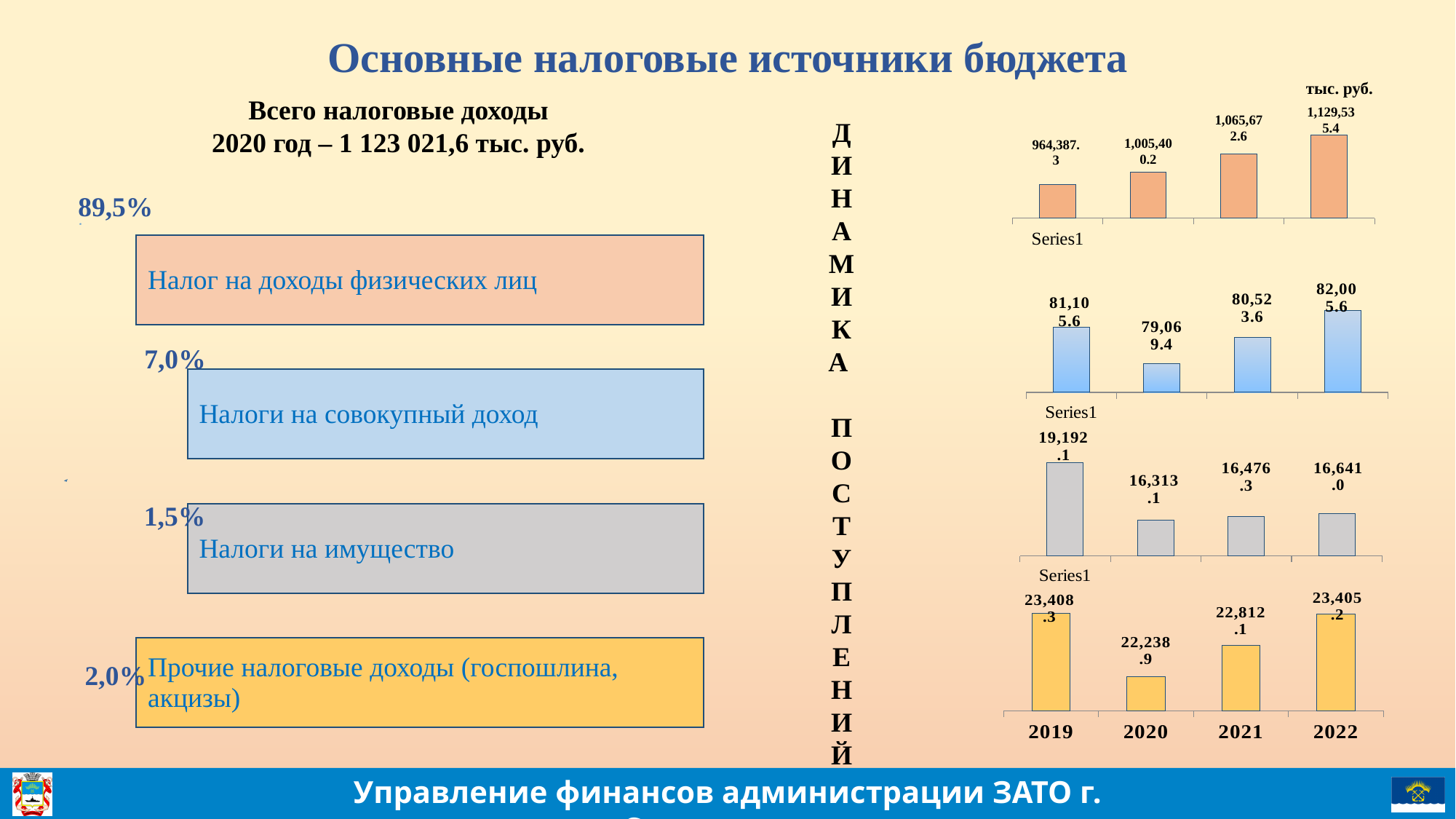
In the bottom (yellow) chart, which year has the lowest value? 2020 In the bottom (yellow) chart, what is the value for 2020? 22,238.9 In the top (orange) chart, what is the value of the rightmost bar? 1,129,535.4 In the second (blue) chart, what is the value of the lowest bar? 79,069.4 What type of chart is the bottom (yellow) chart? bar chart In the third (grey) chart, what is the difference between the first bar and the second bar? 2,879.0 In the bottom (yellow) chart, what is the difference between the 2019 and 2020 values? 1,169.4 In the second (blue) chart, which is larger: the first bar or the fourth bar? the fourth bar In the third (grey) chart, what is the value of the highest bar? 19,192.1 How many bars does the top (orange) chart have? 4 In the top (orange) chart, do the values rise or fall from left to right? rise In the bottom (yellow) chart, which year has the highest value? 2019